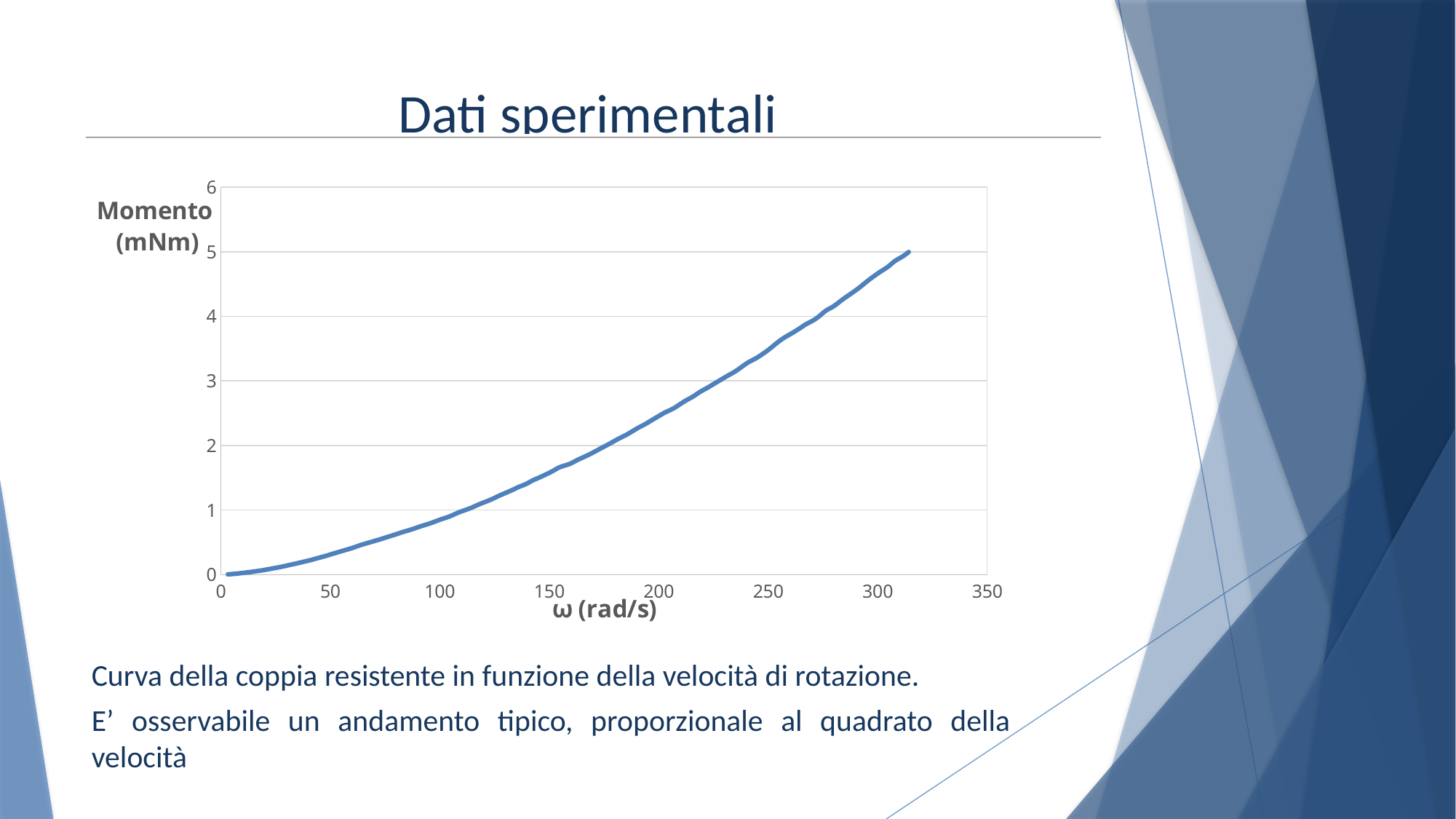
Does the Momento value rise or fall as ω increases along the x axis? rise Which is larger, the Momento value at ω = 100 rad/s or at ω = 250 rad/s? ω = 250 rad/s Is the Momento value at ω = 100 rad/s greater or less than 1? less Is the Momento value at ω = 150 rad/s greater or less than 2? less What is the title of the chart on the slide? Dati sperimentali Is the Momento value at ω = 300 rad/s greater or less than 4? greater At which end of the ω axis does the curve reach its highest Momento value, the low end or the high end? the high end What kind of chart is shown on the slide? line chart What is the label of the horizontal axis of the chart? ω (rad/s)